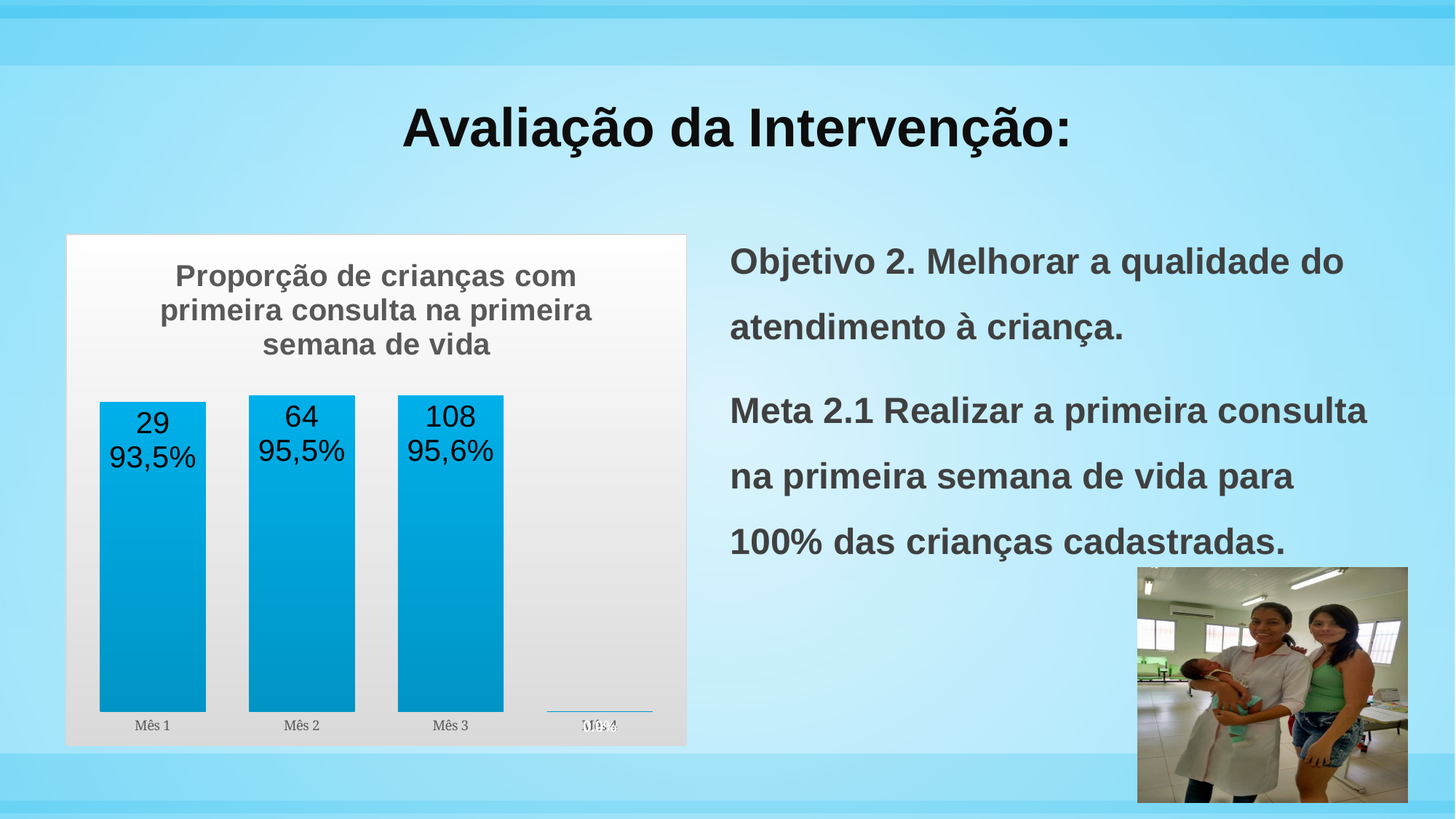
How many bars are plotted in the chart? 3 Do the percentages rise or fall from Mês 1 to Mês 3? rise What percentage is shown for Mês 3? 95,6% What is the title of the chart? Proporção de crianças com primeira consulta na primeira semana de vida What percentage is shown for Mês 2? 95,5% How many children are shown for Mês 3? 108 What kind of chart is shown on the slide? bar chart What is the difference in the number of children between Mês 3 and Mês 2? 44 What percentage is shown for Mês 1? 93,5% How many children are shown for Mês 1? 29 Which month has the highest number of children? Mês 3